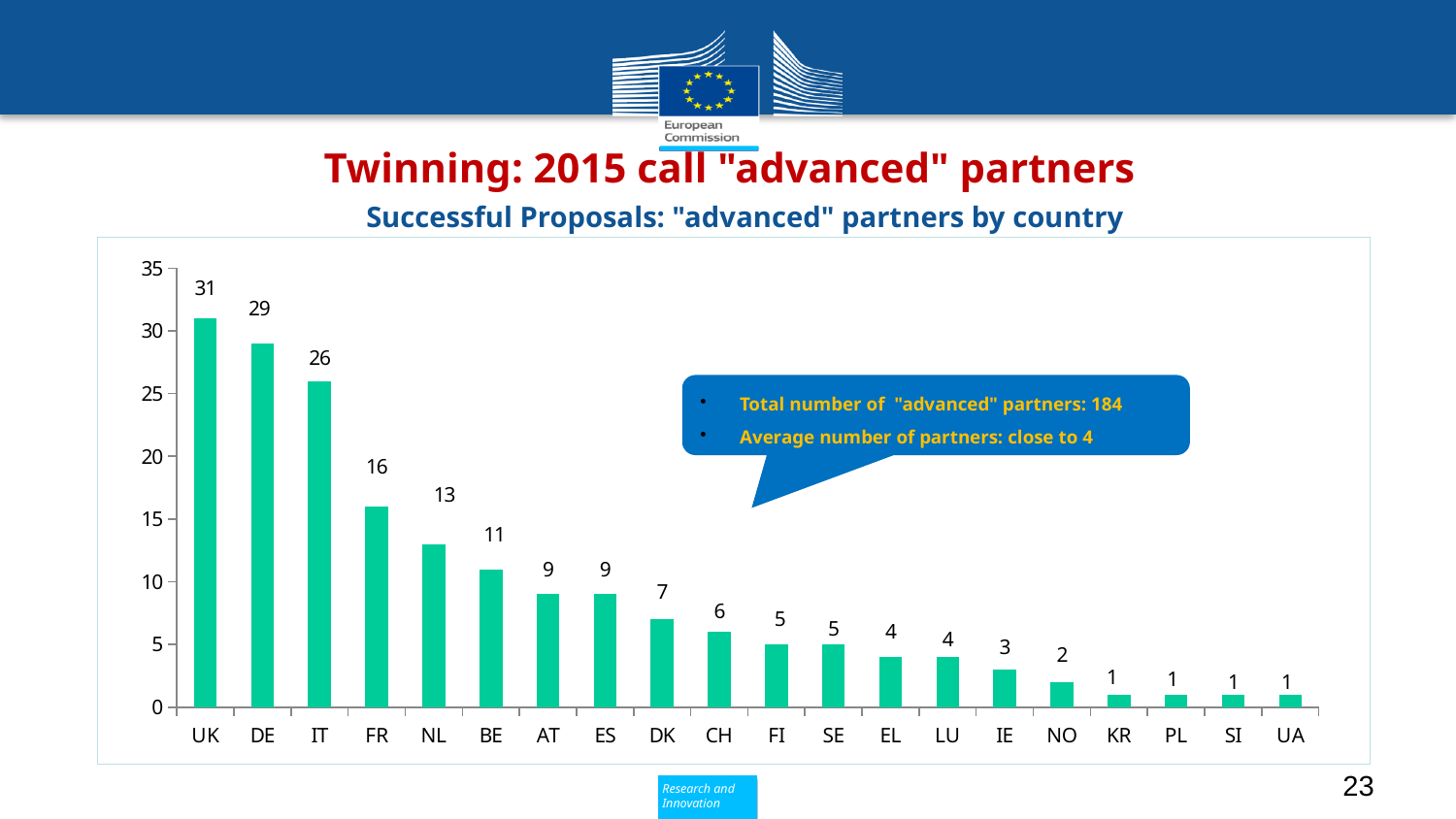
Do the values rise or fall from left to right along the x axis? fall What is the value for CH? 6 What is the difference between the values for DE and IT? 3 What kind of chart is this? bar chart What is the value for UK? 31 How many countries are shown on the x axis? 20 Which country has the highest value? UK What is the value for FR? 16 What is the total number of "advanced" partners stated in the callout box? 184 Is the value for FR greater or less than 15? greater Which is larger, the value for NL or the value for BE? NL What is the title of the chart? Successful Proposals: "advanced" partners by country